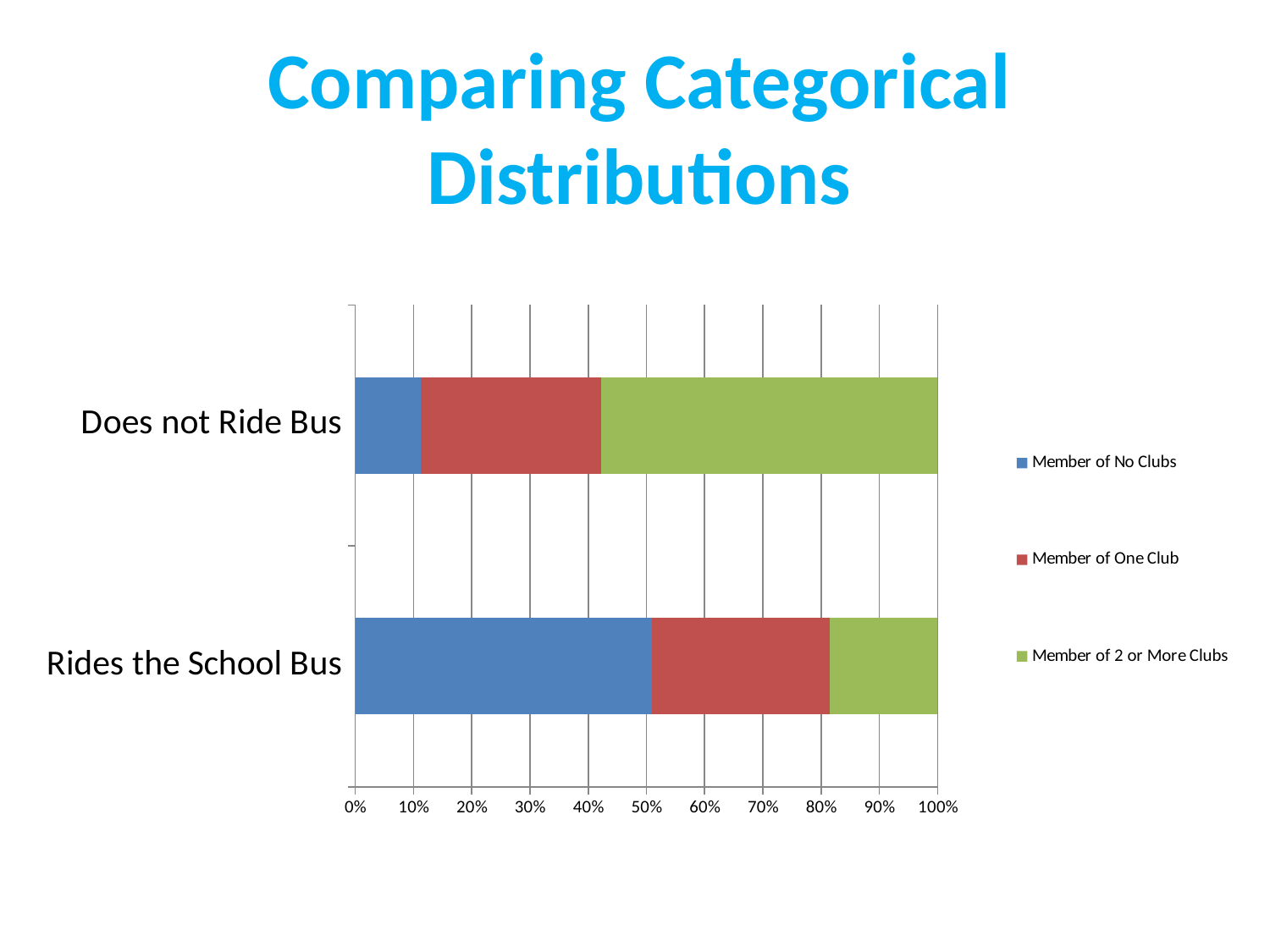
Is the Member of No Clubs value for Rides the School Bus greater or less than 40%? greater Is the Member of No Clubs value for Does not Ride Bus greater or less than 20%? less Which series is shown in green in the legend? Member of 2 or More Clubs Which category has the larger Member of No Clubs share, Does not Ride Bus or Rides the School Bus? Rides the School Bus Is the Member of 2 or More Clubs value for Does not Ride Bus greater or less than 50%? greater How many categories are plotted on the chart? 2 Which series makes up the largest segment of the Does not Ride Bus bar? Member of 2 or More Clubs What is the total of the stacked bar for Rides the School Bus? 100% How many series does the legend list? 3 Which series makes up the smallest segment of the Rides the School Bus bar? Member of 2 or More Clubs What kind of chart is shown on the slide? Stacked bar chart